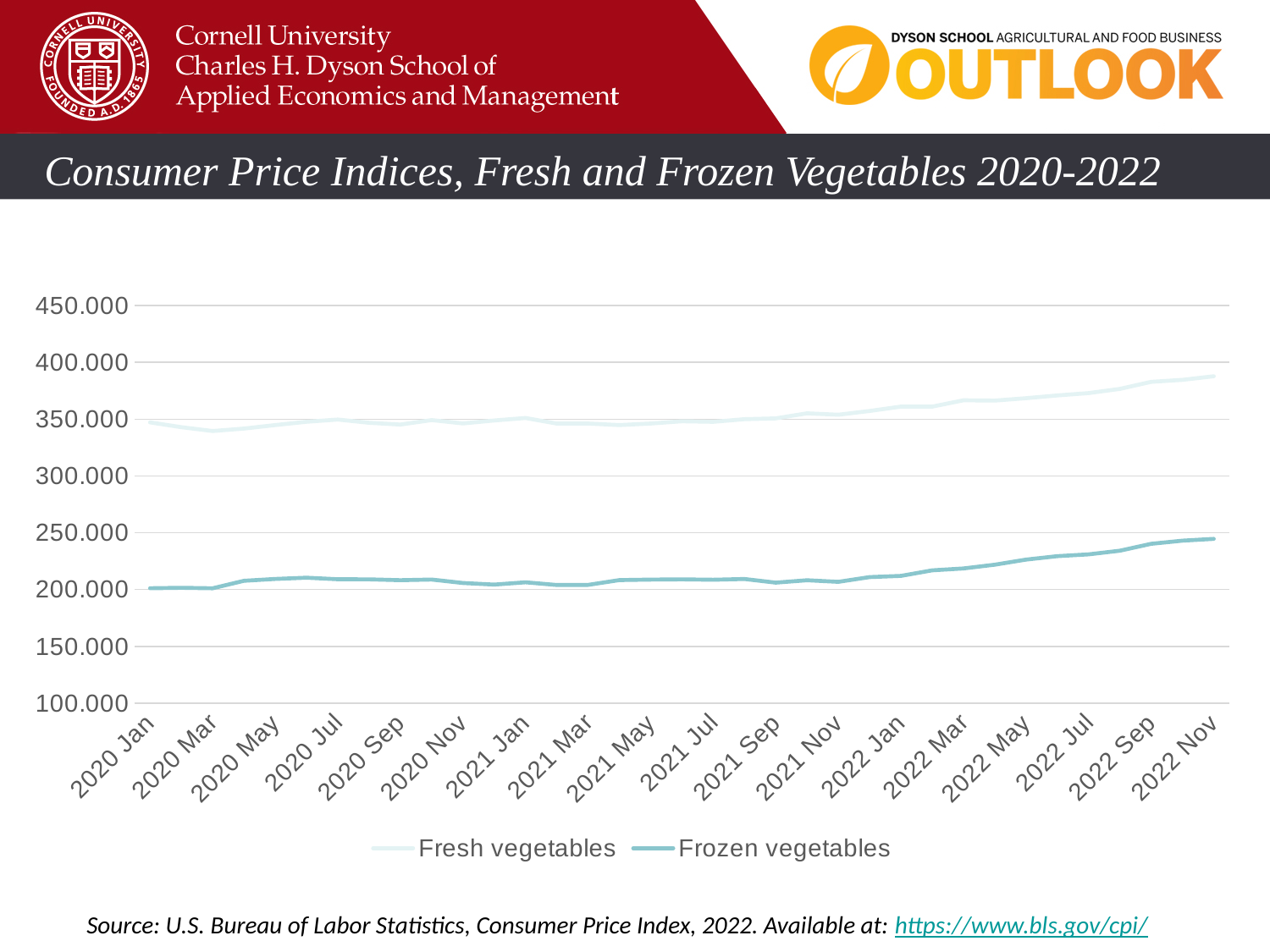
How many month labels are shown on the x axis? 18 Which two series are listed in the legend? Fresh vegetables and Frozen vegetables Does the Frozen vegetables series rise or fall over the course of 2022? Rise Is the value for Fresh vegetables in 2022 Nov greater or less than 350.000? greater Is the value for Fresh vegetables in 2020 Jan greater or less than 400.000? less Is the value for Frozen vegetables in 2022 Nov greater or less than 200.000? greater How many series does the legend list? 2 What kind of chart is shown on the slide? Line chart Which series has the higher values throughout the chart, Fresh vegetables or Frozen vegetables? Fresh vegetables What is the title of the chart? Consumer Price Indices, Fresh and Frozen Vegetables 2020-2022 Does the Fresh vegetables series rise or fall from 2022 Jan to 2022 Nov? Rise